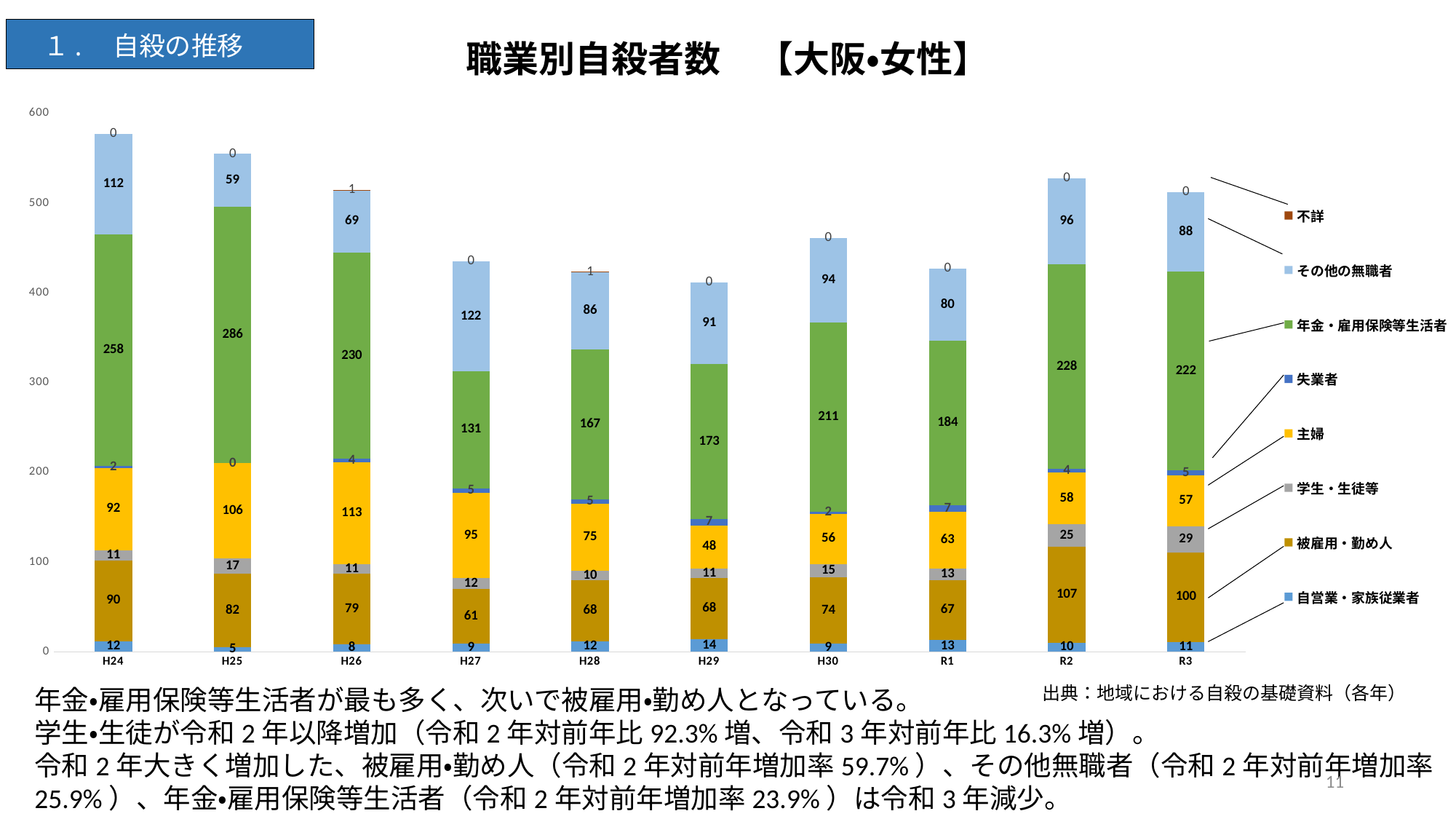
What kind of chart is shown on the slide? stacked bar chart What is the value for 年金・雇用保険等生活者 in H25? 286 What is the value for 学生・生徒等 in R3? 29 What is the value for 被雇用・勤め人 in R2? 107 In which year is the 主婦 value lowest? H29 What is the total of the stacked bar for R2? 528 What is the difference between the その他の無職者 values in H24 and H25? 53 How many years (categories) are shown on the x axis? 10 What is the title of the chart? 職業別自殺者数 【大阪・女性】 In which year is the 年金・雇用保険等生活者 value highest? H25 Which is larger, the 主婦 value in H26 or in H27? H26 How many series does the legend list? 8